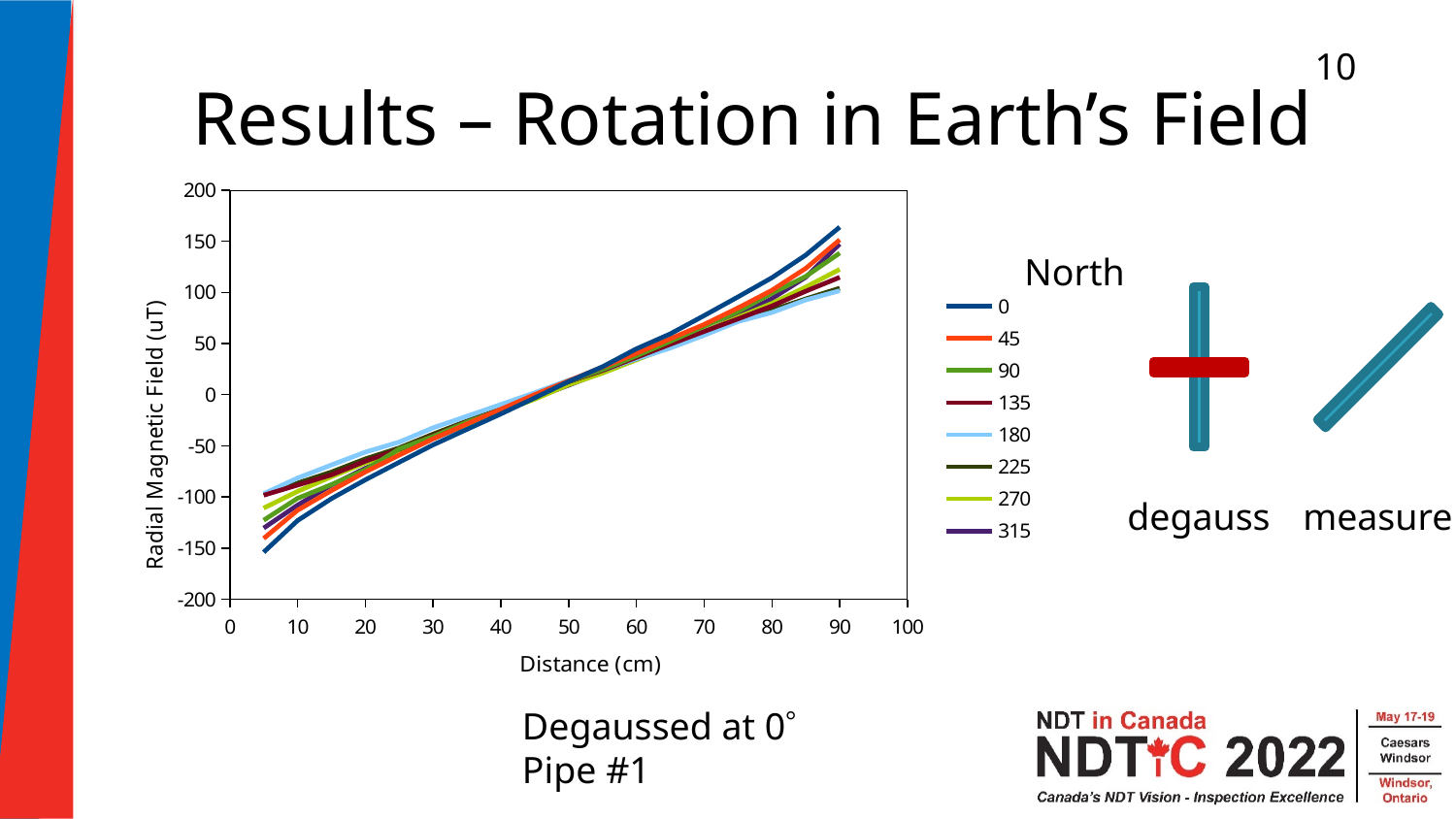
How many series does the chart's legend list? 8 Do the values of the series rise or fall as distance increases along the x axis? rise At 90 cm, is the value for series 180 greater or less than 150? less Which series has the lowest value at the smallest distance plotted (about 5 cm)? 0 At 90 cm, is the value for series 0 greater or less than 150? greater What is the label of the chart's y axis? Radial Magnetic Field (uT) Which series has the highest value at 90 cm? 0 At 10 cm, is the value for series 0 greater or less than -100? less What kind of chart is shown on the slide? line chart At 90 cm, which series has the larger value, 0 or 180? 0 At 90 cm, which series has the larger value, 45 or 180? 45 What is the title of the chart's legend? North